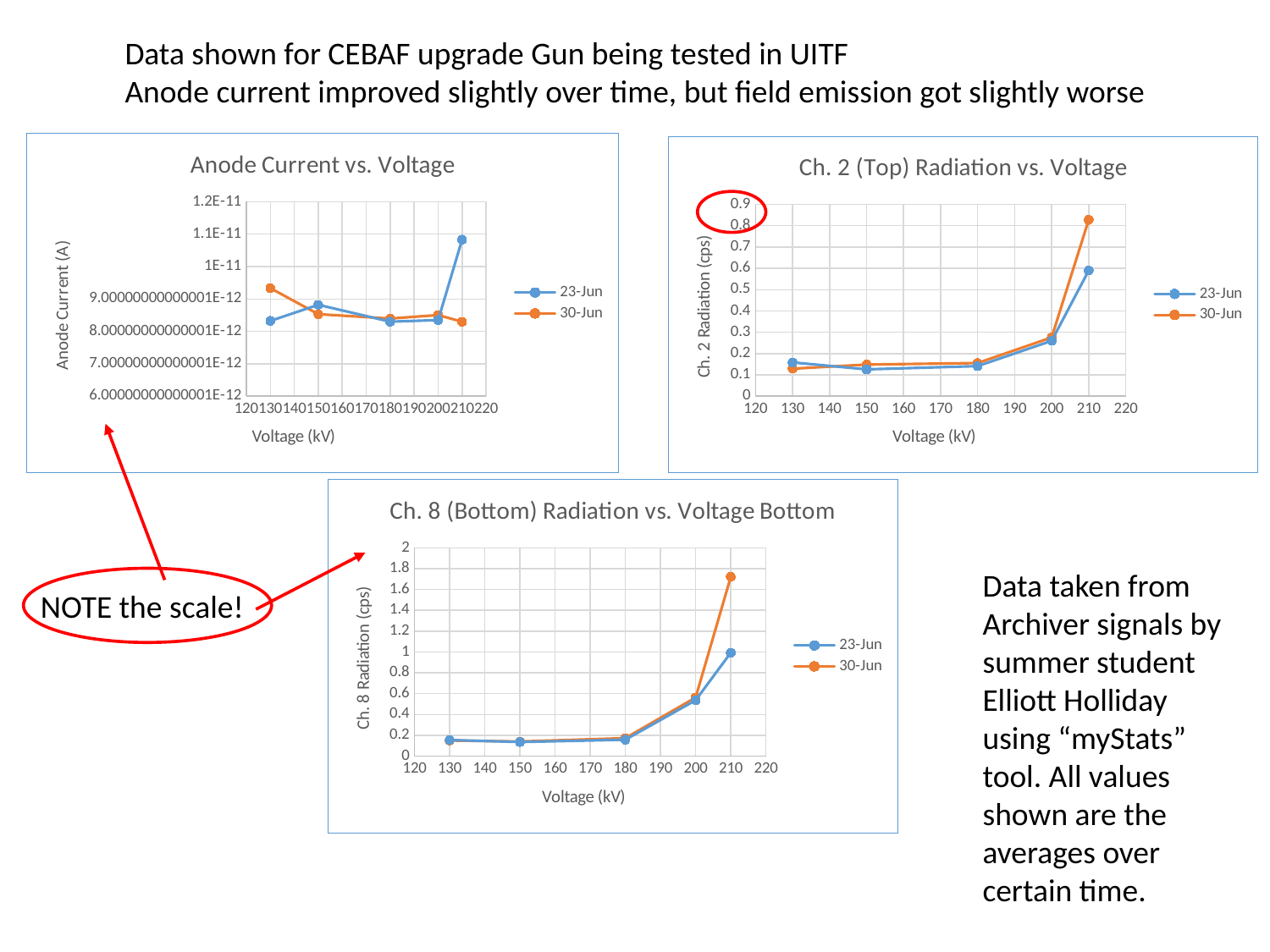
In the "Ch. 2 (Top) Radiation vs. Voltage" chart, is the 30-Jun value at 210 kV greater or less than 0.7? greater In the "Anode Current vs. Voltage" chart, which series has the higher value at 210 kV, 23-Jun or 30-Jun? 23-Jun In the "Anode Current vs. Voltage" chart, is the 23-Jun value at 210 kV greater or less than 1E-11? greater In the "Ch. 8 (Bottom) Radiation vs. Voltage Bottom" chart, is the 30-Jun value at 210 kV greater or less than 1.6? greater In the "Ch. 8 (Bottom) Radiation vs. Voltage Bottom" chart, at which voltage does the 30-Jun series reach its highest value? 210 What is the y-axis title of the "Ch. 2 (Top) Radiation vs. Voltage" chart? Ch. 2 Radiation (cps) In the "Ch. 8 (Bottom) Radiation vs. Voltage Bottom" chart, how many data points does the 30-Jun series have? 5 What kind of chart is the "Anode Current vs. Voltage" chart? Line chart In the "Ch. 2 (Top) Radiation vs. Voltage" chart, which series has the higher value at 210 kV, 23-Jun or 30-Jun? 30-Jun In the "Ch. 2 (Top) Radiation vs. Voltage" chart, how many series does the legend list? 2 In the "Ch. 2 (Top) Radiation vs. Voltage" chart, does the 23-Jun series rise or fall between 180 kV and 210 kV? Rise